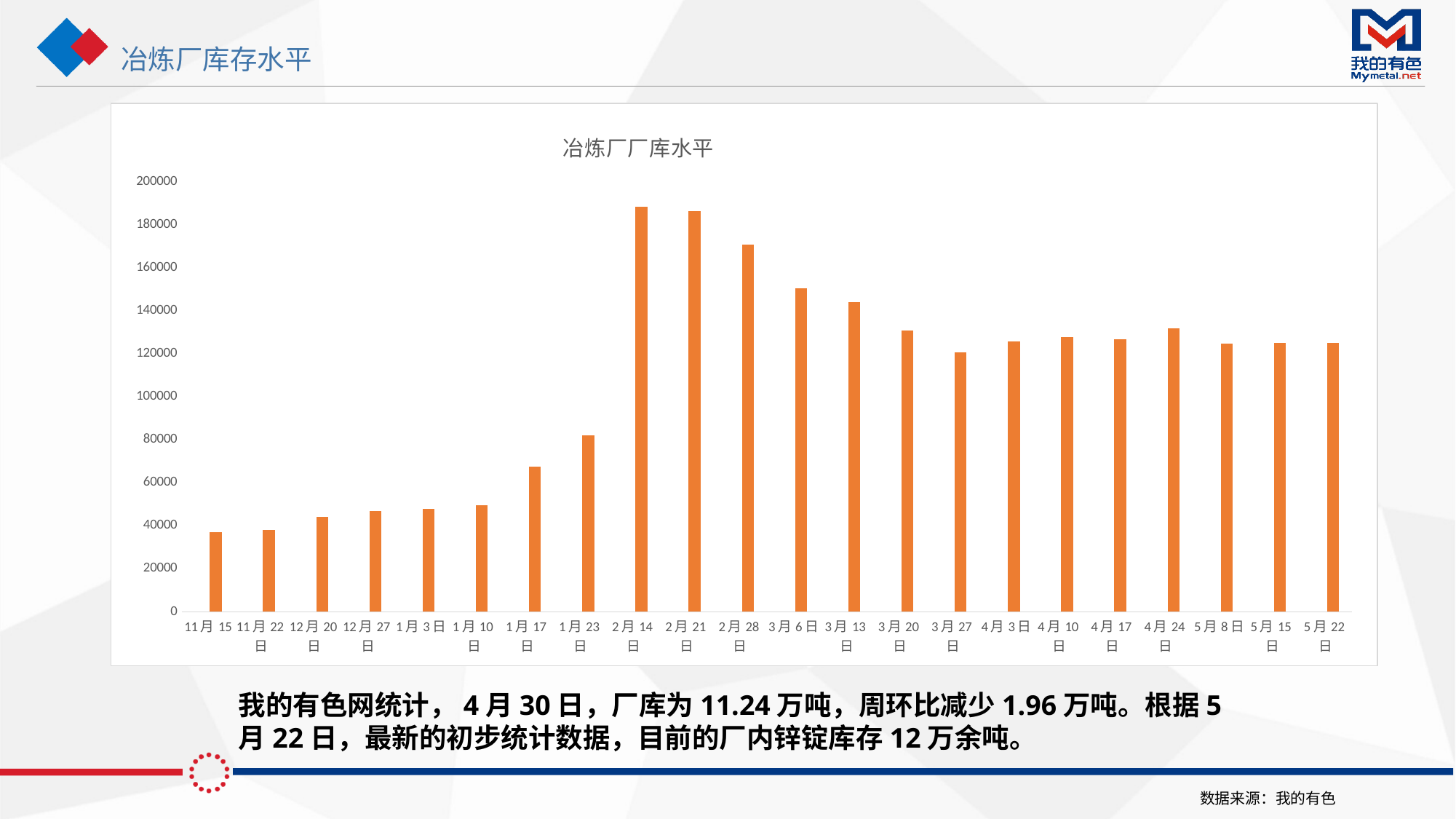
What is the title of the chart? 冶炼厂厂库水平 Is the value for 5月22日 greater or less than 120000? greater What kind of chart is shown on the slide? bar chart Do the values rise or fall from 2月14日 to 3月27日? fall Is the value for 11月15日 greater or less than 40000? less Is the value for 2月28日 greater or less than 160000? greater Do the values rise or fall from 11月15日 to 2月14日? rise Which is larger, the value for 1月17日 or the value for 1月23日? 1月23日 How many bars (dates) are plotted in the chart? 22 Which is larger, the value for 2月14日 or the value for 5月22日? 2月14日